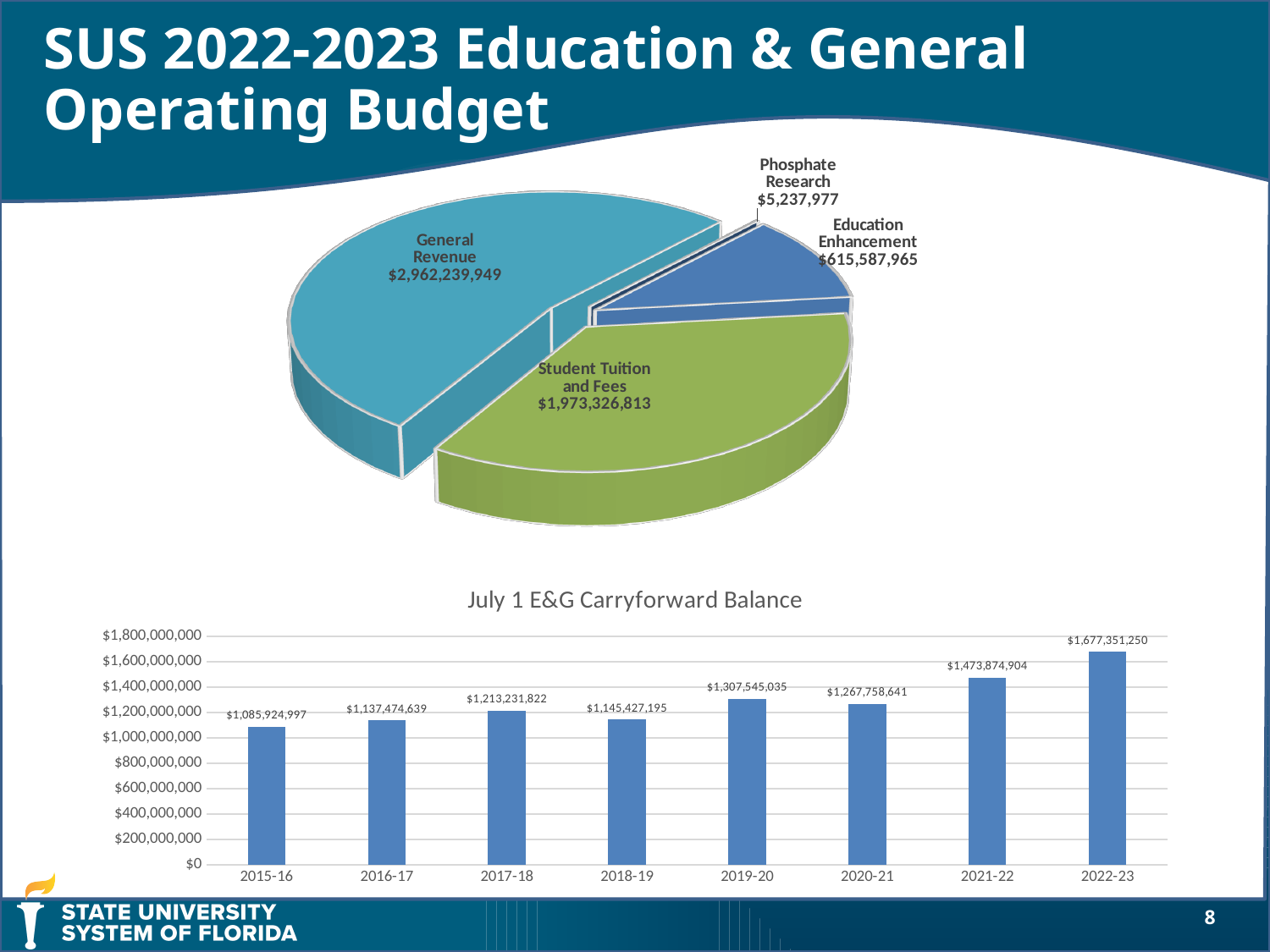
In the pie chart at the top of the slide, what is the value for General Revenue? $2,962,239,949 In the pie chart at the top of the slide, which category has the largest slice? General Revenue In the pie chart at the top of the slide, how much larger is General Revenue than Student Tuition and Fees? $988,913,136 In the pie chart at the top of the slide, which category has the smallest slice? Phosphate Research What kind of chart is the 'July 1 E&G Carryforward Balance' chart? Bar chart In the pie chart at the top of the slide, how many categories are shown? 4 In the pie chart at the top of the slide, what is the value for Phosphate Research? $5,237,977 In the 'July 1 E&G Carryforward Balance' chart, which year has the lowest balance? 2015-16 In the 'July 1 E&G Carryforward Balance' chart, which is larger, the value for 2017-18 or the value for 2018-19? 2017-18 In the 'July 1 E&G Carryforward Balance' chart, which year has the highest balance? 2022-23 In the 'July 1 E&G Carryforward Balance' chart, what is the difference between the 2022-23 and 2021-22 values? $203,476,346 In the 'July 1 E&G Carryforward Balance' chart, what is the value for 2019-20? $1,307,545,035